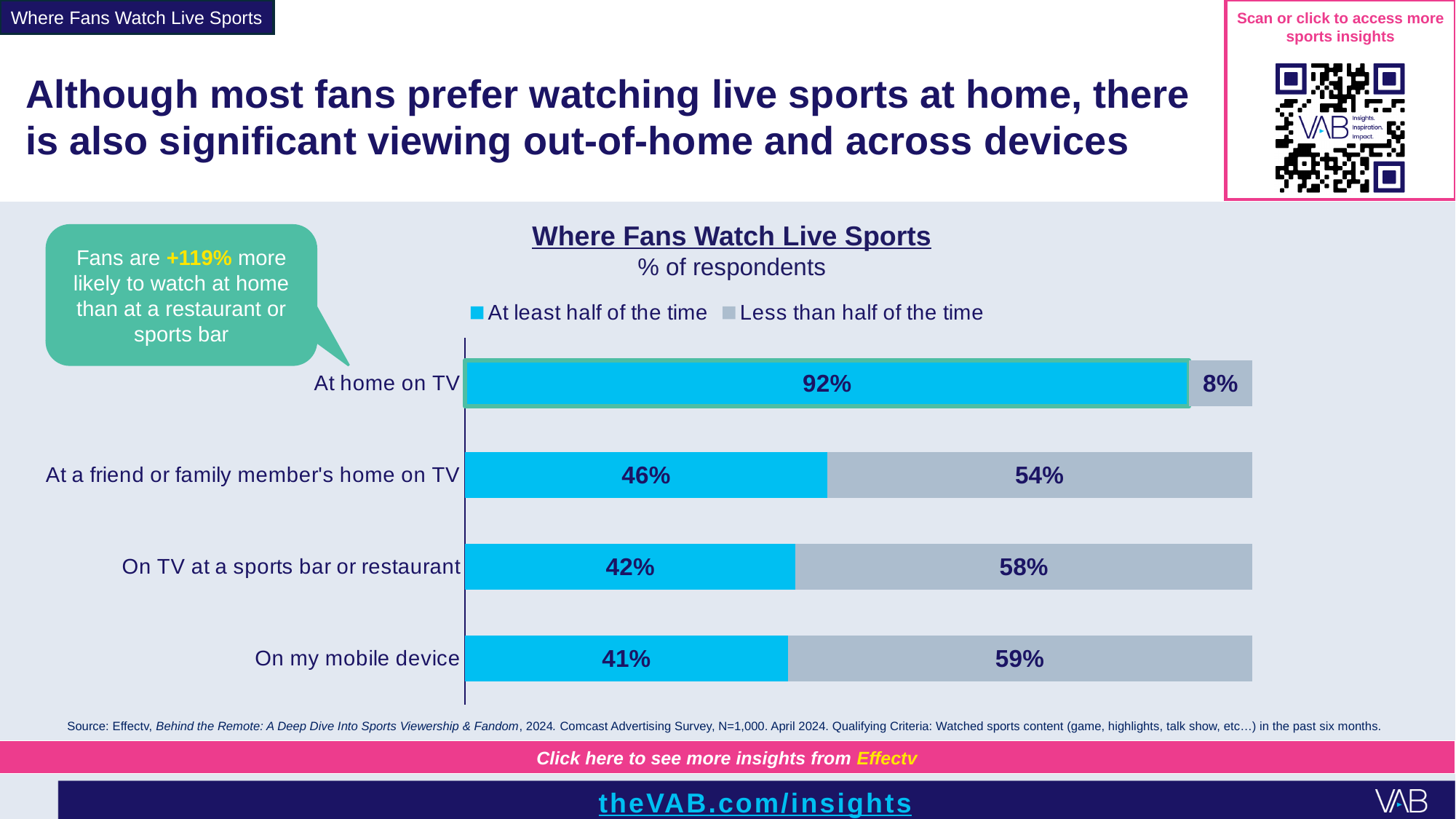
What type of chart is shown on the slide? Stacked bar chart How many series does the legend list? 2 What is the difference between the 'At least half of the time' values for 'At home on TV' and 'On TV at a sports bar or restaurant'? 50 percentage points Which is larger for 'At a friend or family member's home on TV': the 'At least half of the time' share or the 'Less than half of the time' share? Less than half of the time What is the 'At least half of the time' value for 'On TV at a sports bar or restaurant'? 42% Which location has the lowest 'At least half of the time' percentage? On my mobile device What is the title of the chart? Where Fans Watch Live Sports What percentage of respondents watch live sports on their mobile device less than half of the time? 59% What percentage of respondents watch live sports at home on TV at least half of the time? 92% How many locations (categories) are shown in the chart? 4 What is the total of the two segments for the 'At home on TV' bar? 100% Which location has the highest 'At least half of the time' percentage? At home on TV